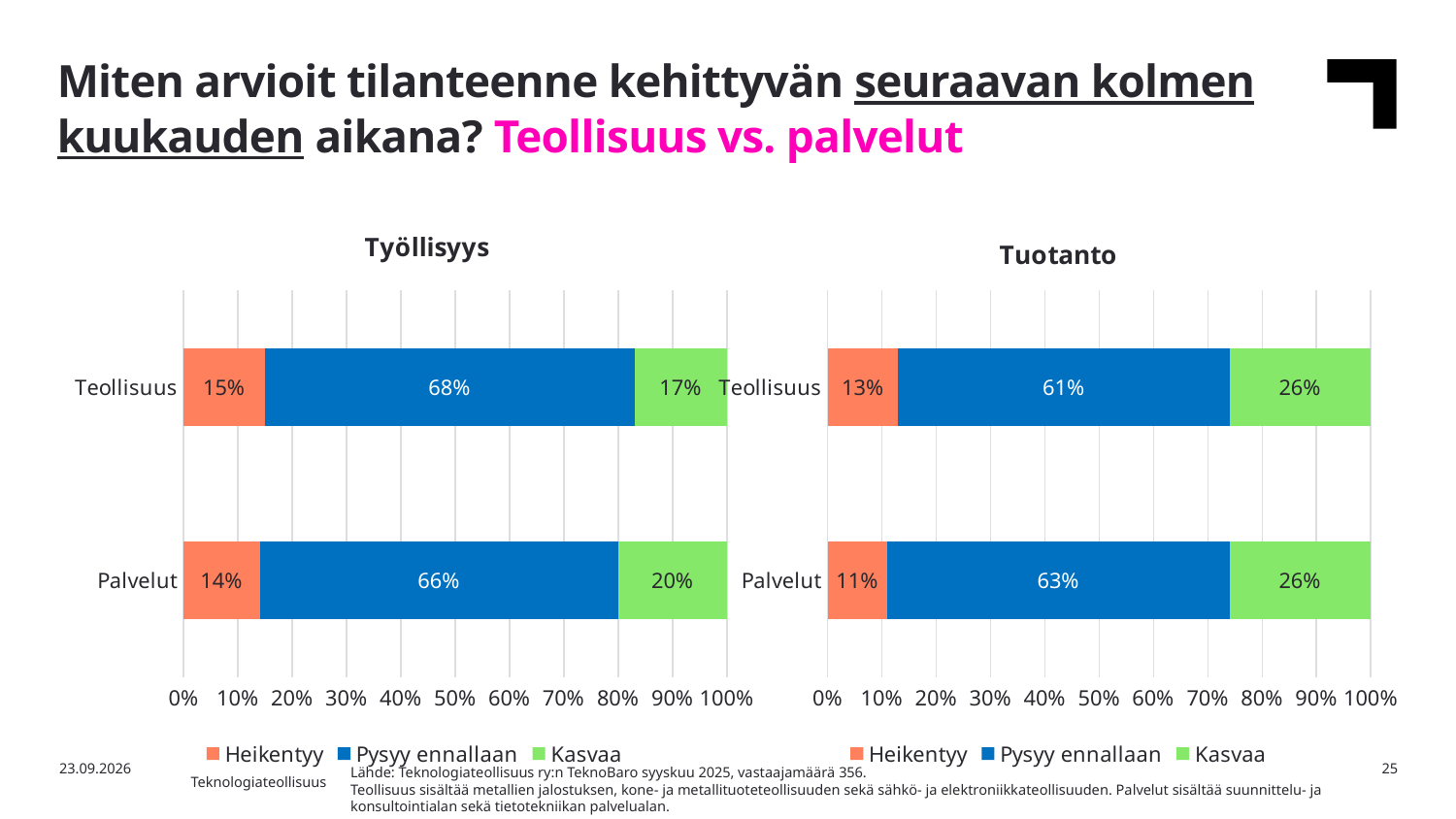
In the Tuotanto chart, what is the Kasvaa value for Palvelut? 26% In the Tuotanto chart, what is the Heikentyy value for Teollisuus? 13% What kind of chart is the Tuotanto chart? Stacked bar chart In the Työllisyys chart, what is the difference between the Kasvaa values for Palvelut and Teollisuus? 3% In the Työllisyys chart, which category has the higher Kasvaa value? Palvelut How many series does the legend of the Tuotanto chart list? 3 In the Tuotanto chart, what is the difference between the Pysyy ennallaan values for Palvelut and Teollisuus? 2% In the Tuotanto chart, what is the total of the stacked bar for Teollisuus? 100% In the Työllisyys chart, what is the Pysyy ennallaan value for Teollisuus? 68% How many categories are shown in the Työllisyys chart? 2 In the Työllisyys chart, what is the Heikentyy value for Palvelut? 14% Which colour represents Heikentyy in the Työllisyys chart legend? Orange